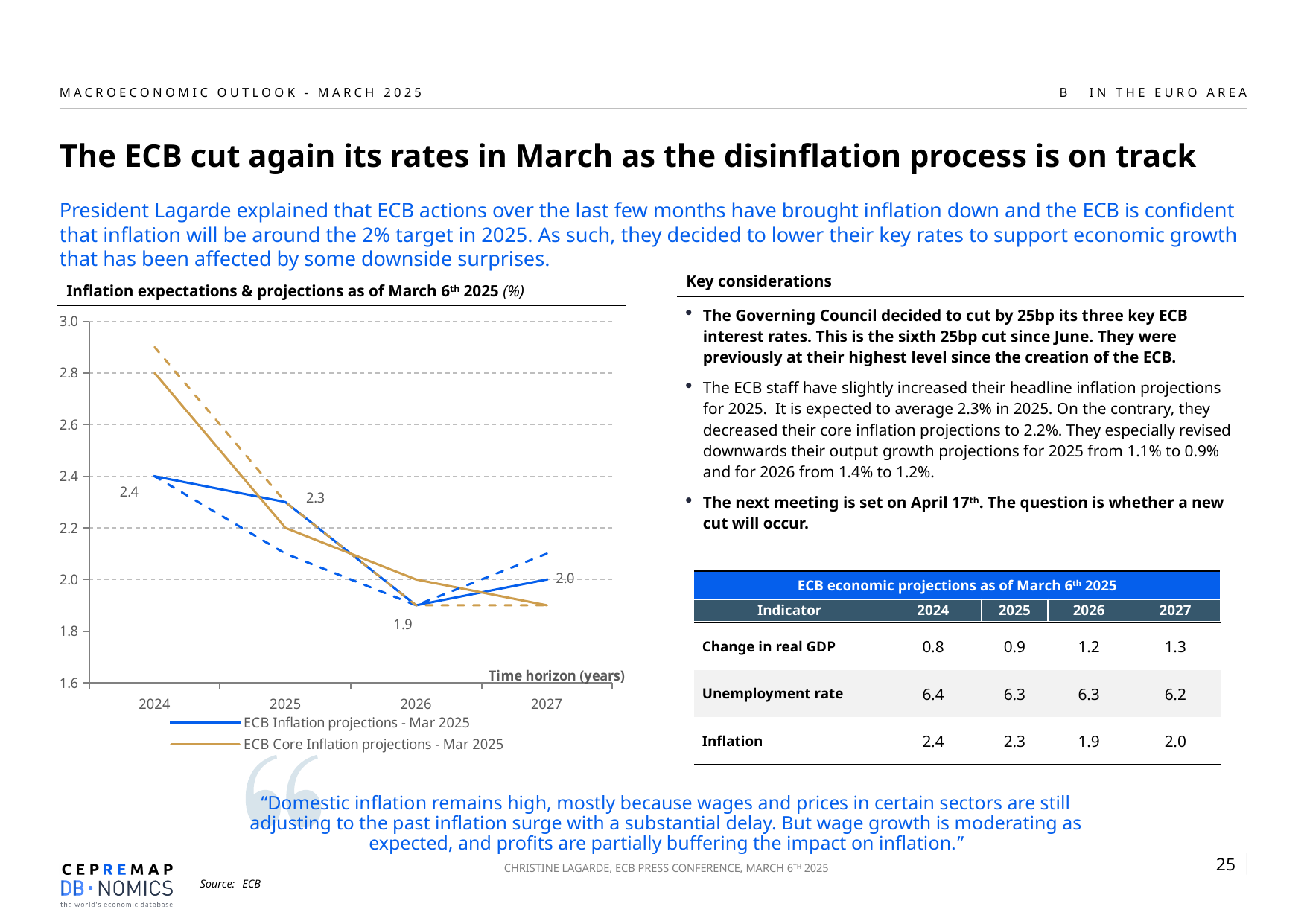
In which year is the ECB Inflation projection (Mar 2025) lowest? 2026 In which year is the ECB Inflation projection (Mar 2025) highest? 2024 Is the ECB Core Inflation projection (Mar 2025) for 2024 greater or less than 2.6? greater What is the ECB Inflation projection (Mar 2025) for 2024? 2.4 In 2024, which is higher: the ECB Core Inflation projection or the ECB Inflation projection? ECB Core Inflation projections - Mar 2025 What kind of chart is shown under 'Inflation expectations & projections as of March 6th 2025'? line chart How many series does the chart legend list? 2 What is the ECB Inflation projection (Mar 2025) for 2027? 2.0 What is the ECB Inflation projection (Mar 2025) for 2025? 2.3 How many years are shown on the x axis of the chart? 4 What is the ECB Inflation projection (Mar 2025) for 2026? 1.9 What is the difference between the ECB Inflation projection for 2024 and for 2026? 0.5